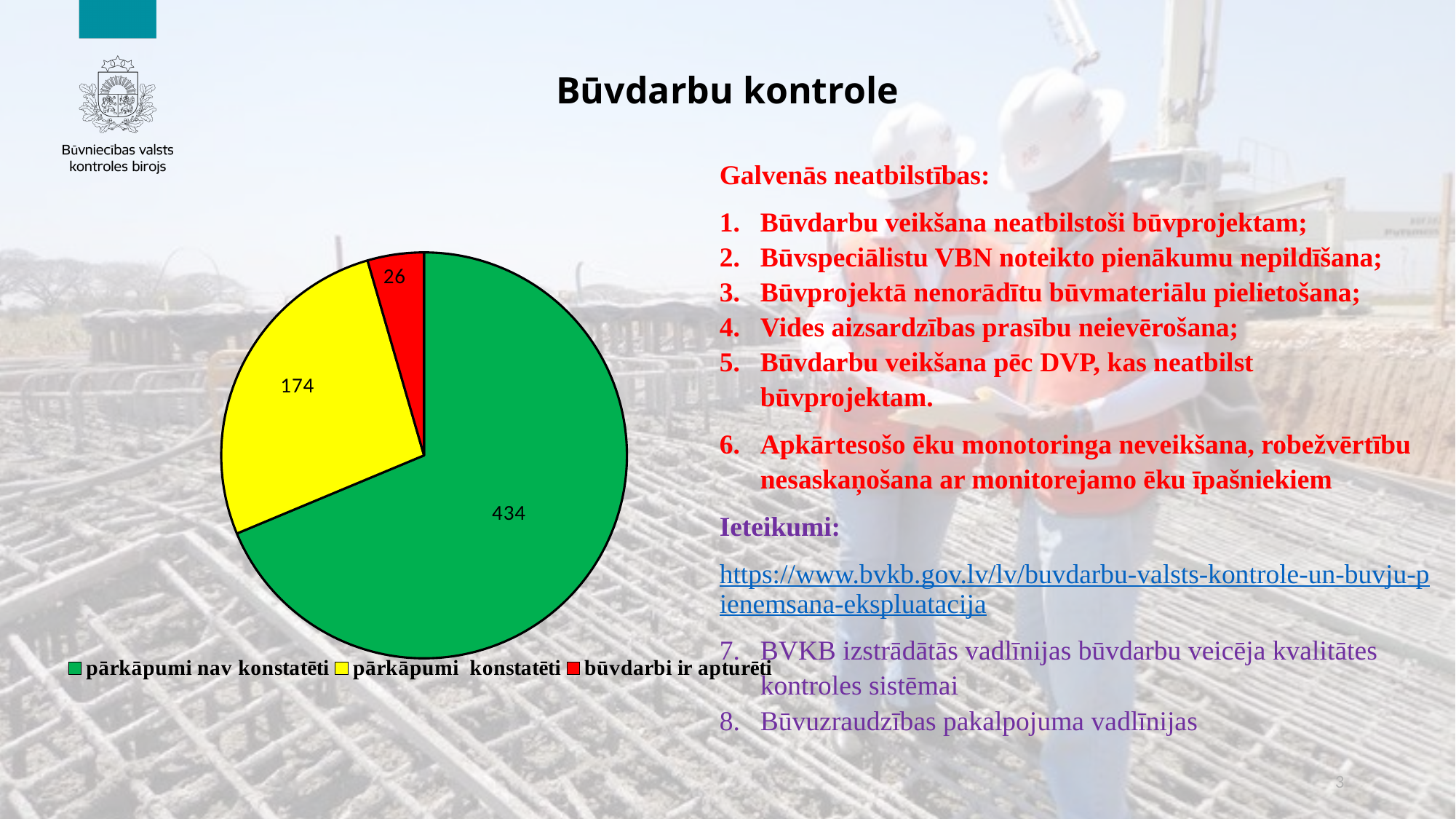
What is the value for 'pārkāpumi nav konstatēti'? 434 Which category has the smallest slice of the pie? būvdarbi ir apturēti Which is larger: the value for 'pārkāpumi konstatēti' or the value for 'būvdarbi ir apturēti'? pārkāpumi konstatēti What is the difference between the values for 'pārkāpumi konstatēti' and 'būvdarbi ir apturēti'? 148 How many slices does the pie chart have? 3 What colour is the slice for 'būvdarbi ir apturēti'? red What kind of chart is shown on the slide? pie chart Which category has the largest slice of the pie? pārkāpumi nav konstatēti What is the value for 'pārkāpumi konstatēti'? 174 What is the value for 'būvdarbi ir apturēti'? 26 What is the total of all the values shown in the pie chart? 634 What is the difference between the values for 'pārkāpumi nav konstatēti' and 'pārkāpumi konstatēti'? 260